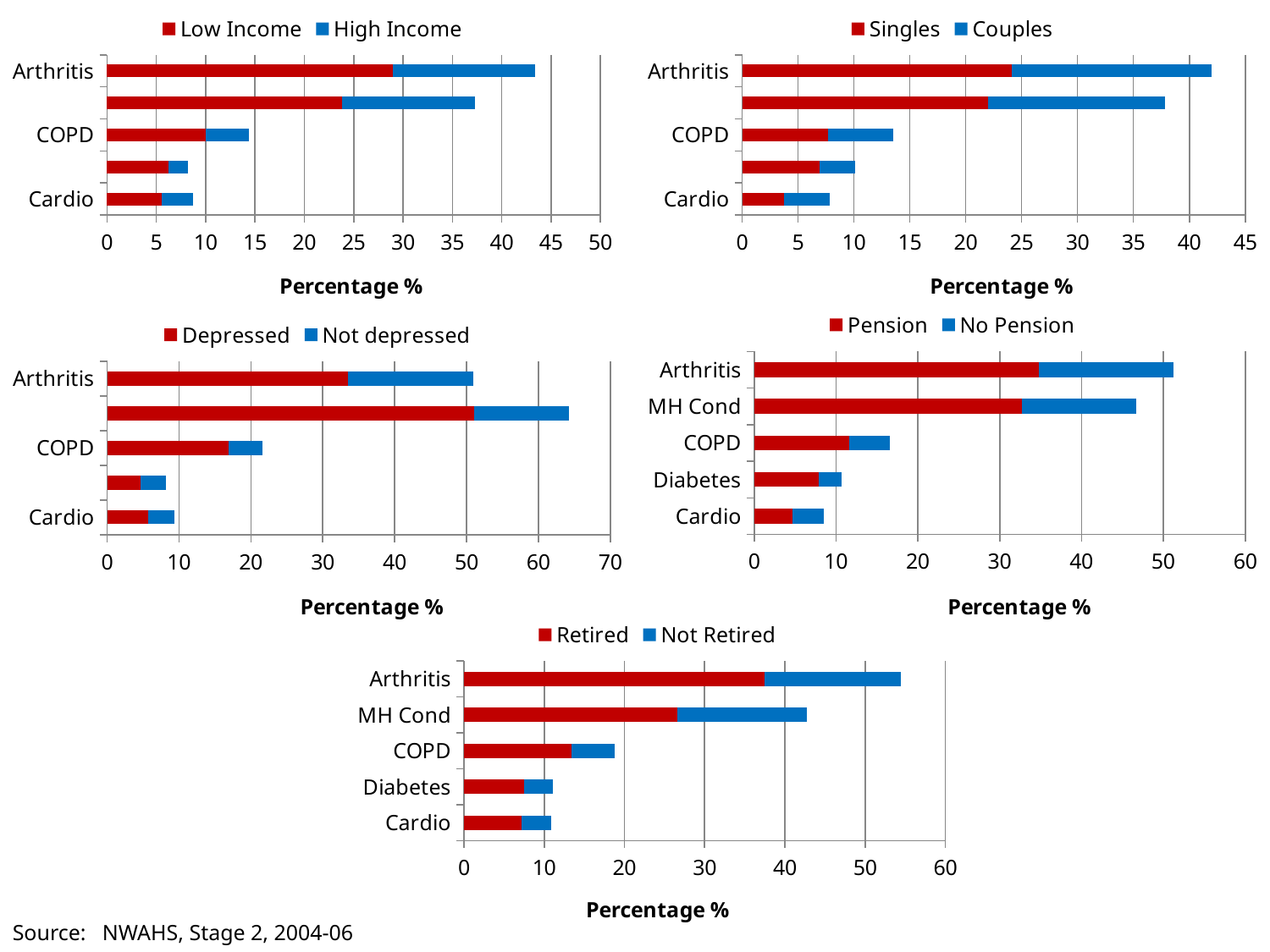
In the bottom chart (Retired / Not Retired), which condition has the longest total bar? Arthritis In the bottom chart (Retired / Not Retired), how many condition categories are shown? 5 What is the x-axis title shown under each chart? Percentage % In the top-left chart (Low Income / High Income), how many series does the legend list? 2 In the bottom chart (Retired / Not Retired), is the Retired segment for Arthritis greater or less than 30? greater In the middle-left chart (Depressed / Not depressed), is the total value for COPD greater or less than 30? less What kind of chart is the bottom chart with the Retired and Not Retired legend? bar chart In the top-left chart (Low Income / High Income), is the total value for Arthritis greater or less than 40? greater In the middle-right chart (Pension / No Pension), which has the larger total bar, COPD or Diabetes? COPD In the bottom chart (Retired / Not Retired), which has the larger total bar, Arthritis or MH Cond? Arthritis